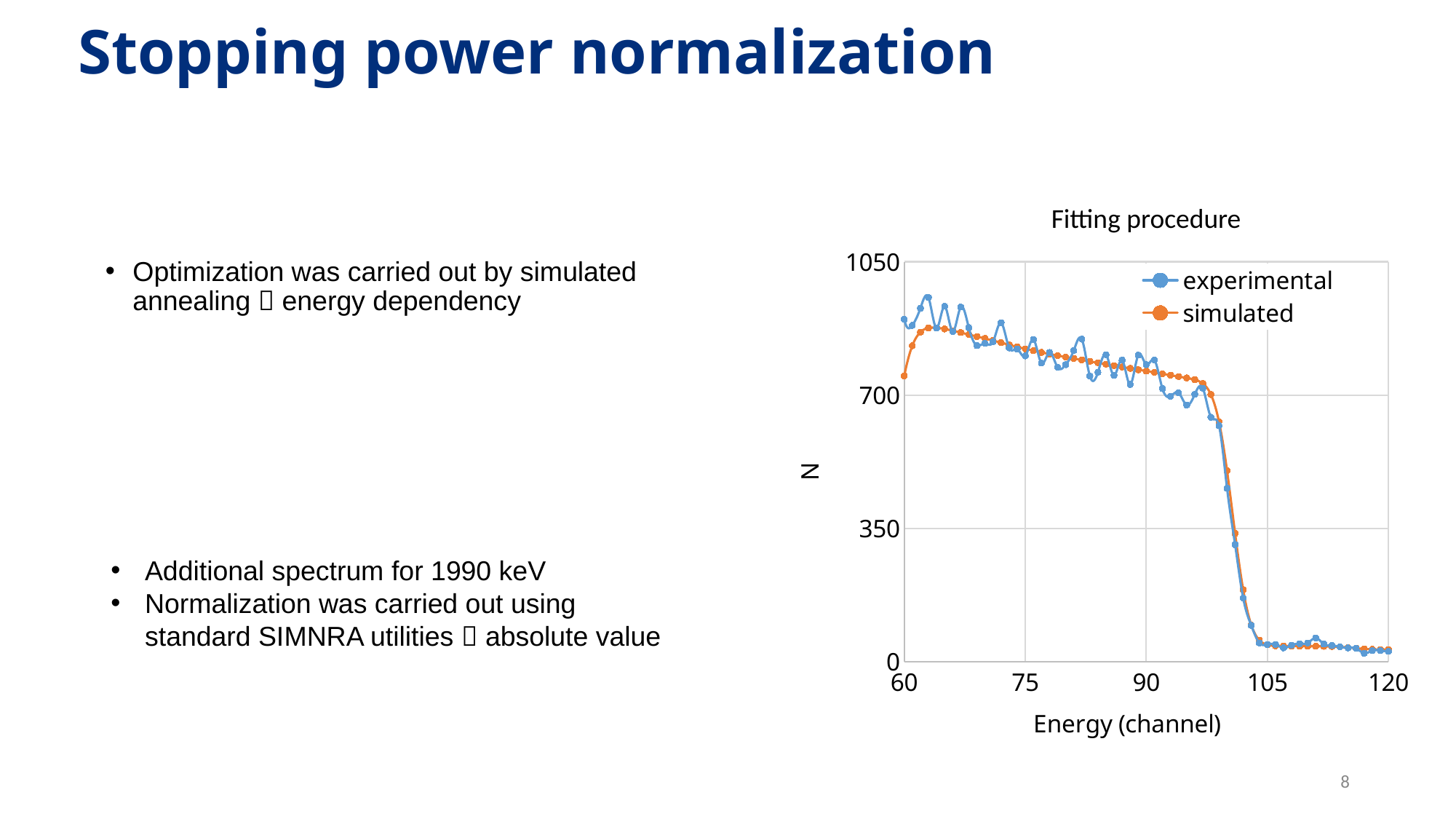
What is the title of the chart? Fitting procedure Is the value of the simulated series at channel 60 greater or less than 1050? less Do the values of the experimental series generally rise or fall as the energy channel increases from 60 to 120? fall Is the value of the simulated series at channel 105 greater or less than 350? less What is the label of the x axis of the chart? Energy (channel) What kind of chart is shown on the slide? line chart Is the value of the experimental series at channel 90 greater or less than 700? greater How many series does the legend of the chart list? 2 Which series has the larger value at channel 60, experimental or simulated? experimental